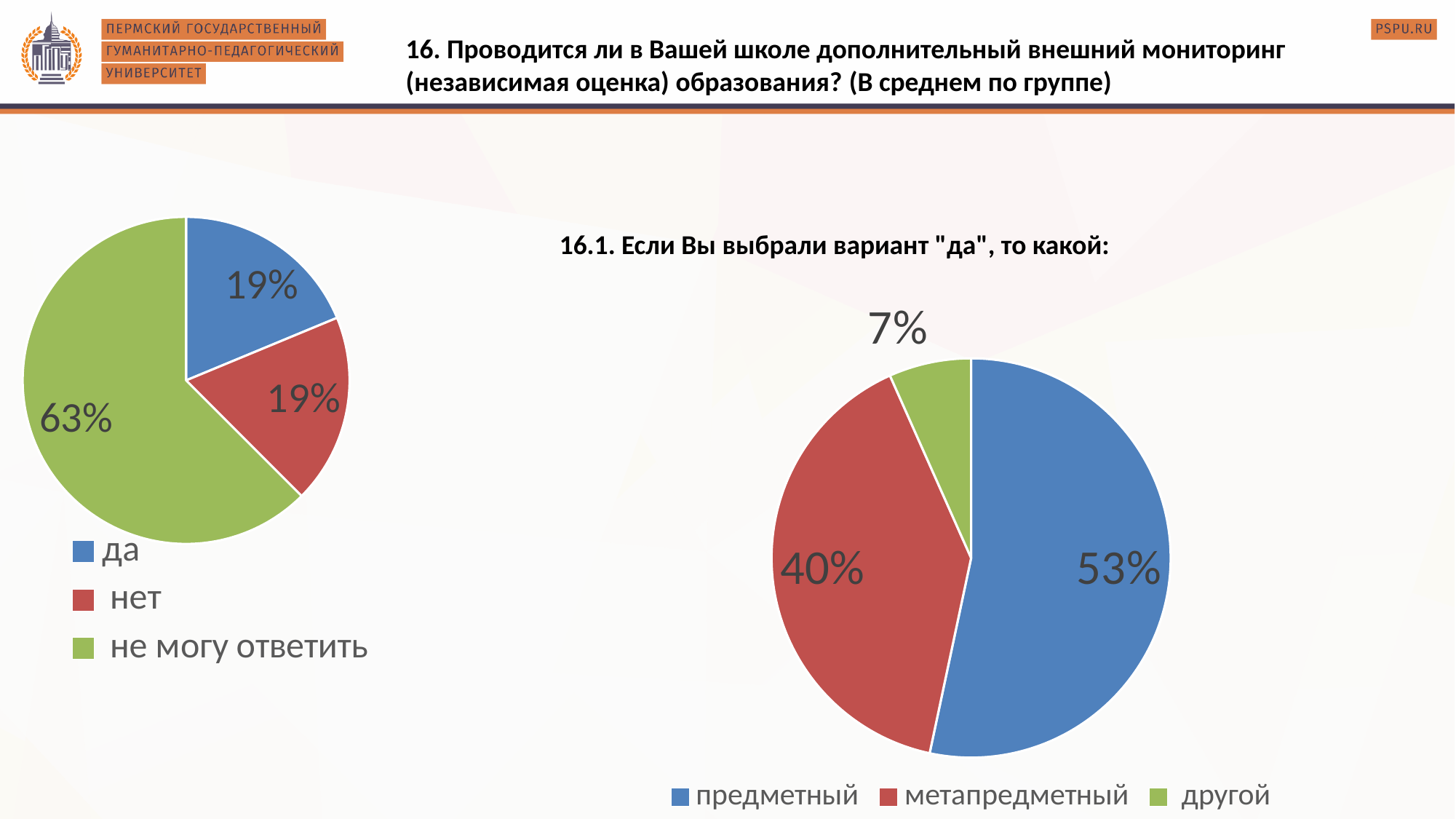
In the left pie chart, what is the difference between the share for "не могу ответить" and the share for "нет"? 44% How many slices does the left pie chart have? 3 What type of chart is used on the right side of the slide (16.1)? Pie chart In the right pie chart (16.1), what share is labelled "другой"? 7% In the right pie chart (16.1), which category has the smallest share? другой In the right pie chart (16.1), what share is labelled "предметный"? 53% In the right pie chart (16.1), what is the difference between the shares for "предметный" and "метапредметный"? 13% In the left pie chart, what share of respondents answered "да"? 19% In the right pie chart (16.1), which colour represents "метапредметный"? Red In the left pie chart, what share of respondents answered "не могу ответить"? 63% In the left pie chart, which answer has the largest share? не могу ответить In the left pie chart, which is larger: the share for "да" or the share for "не могу ответить"? не могу ответить